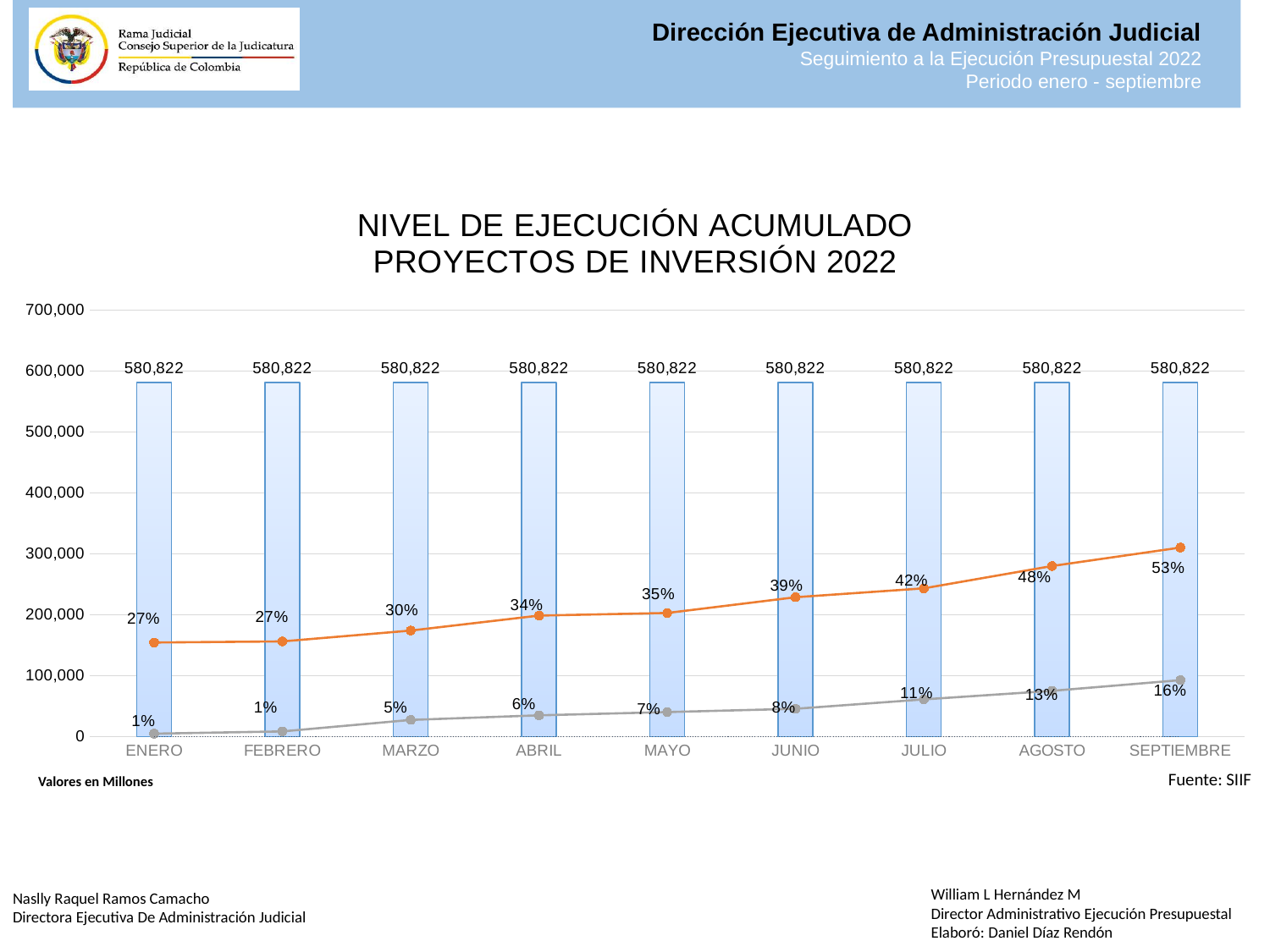
What kind of chart is shown on the slide? Combined bar and line chart How many months are shown on the x axis? 9 Is the value of the bar for MARZO greater or less than 500,000? greater What percentage does the grey line show for JULIO? 11% Does the orange line rise or fall from ENERO to SEPTIEMBRE? Rises By how many percentage points does the orange line value for SEPTIEMBRE exceed the value for ENERO? 26 percentage points Which month has the larger orange line value, MAYO or JUNIO? JUNIO In which month does the grey line reach its highest value? SEPTIEMBRE In which month does the orange line reach its highest value? SEPTIEMBRE What percentage does the orange line show for ABRIL? 34% What is the value of the bar for ENERO? 580,822 What percentage does the orange line show for SEPTIEMBRE? 53%